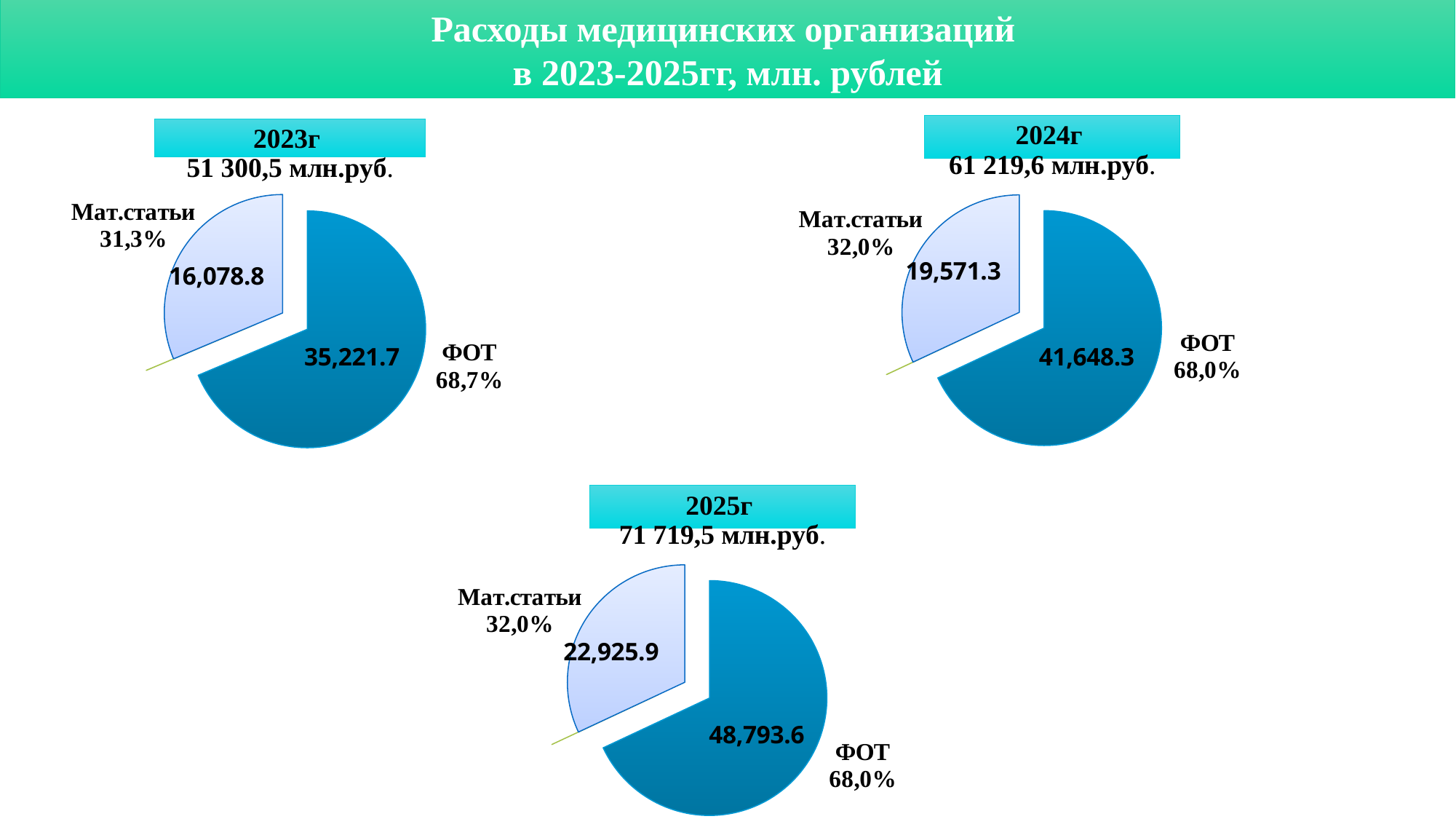
How many slices does the 2023г pie chart have? 2 Which is larger: the Мат.статьи value in the 2024г chart or the Мат.статьи value in the 2023г chart? 2024г In the 2024г pie chart, what is the value for Мат.статьи? 19,571.3 In the 2024г pie chart, which slice is the smallest? Мат.статьи In the 2025г pie chart, what is the value for ФОТ? 48,793.6 In the 2025г pie chart, what is the difference between the ФОТ value and the Мат.статьи value? 25,867.7 What type of chart is used for the 2024г data? Pie chart In the 2023г pie chart, what is the value for Мат.статьи? 16,078.8 In the 2025г pie chart, which slice is the largest? ФОТ In the 2023г pie chart, what is the value for ФОТ? 35,221.7 In the 2023г pie chart, what share of the pie does ФОТ take? 68,7% In the 2024г pie chart, what share of the pie does Мат.статьи take? 32,0%